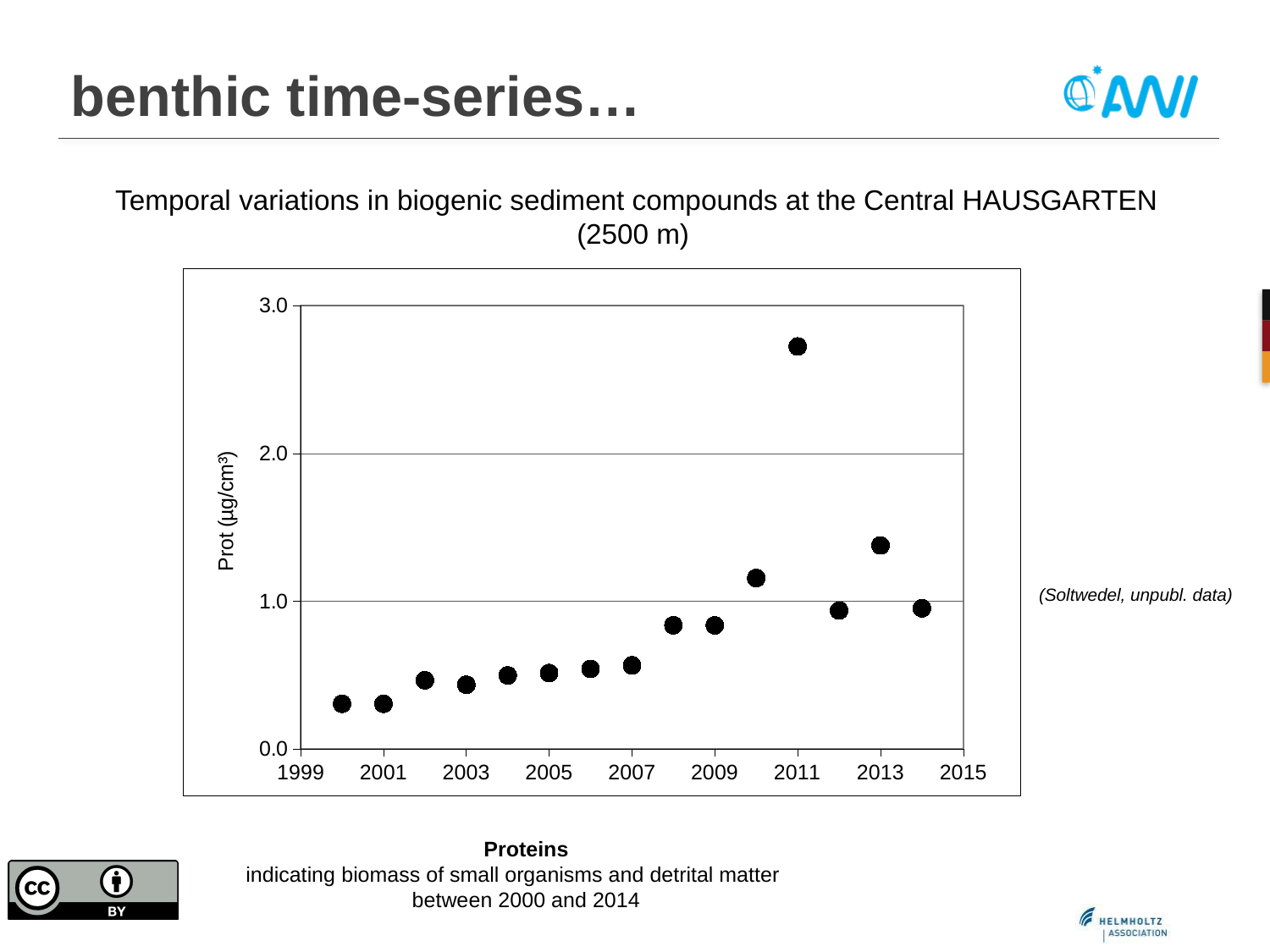
Which year has the larger protein value, 2008 or 2010? 2010 How many data points are plotted in the chart? 15 What kind of chart is shown on the slide? scatter plot What is the label of the y axis? Prot (µg/cm³) Is the value for 2008 greater or less than 1.0? less Is the value for 2011 greater or less than 2.0? greater In which year is the protein value highest? 2011 Is the value for 2010 greater or less than 1.0? greater Do the protein values generally rise or fall from 2000 to 2010? rise Which year has the larger protein value, 2011 or 2013? 2011